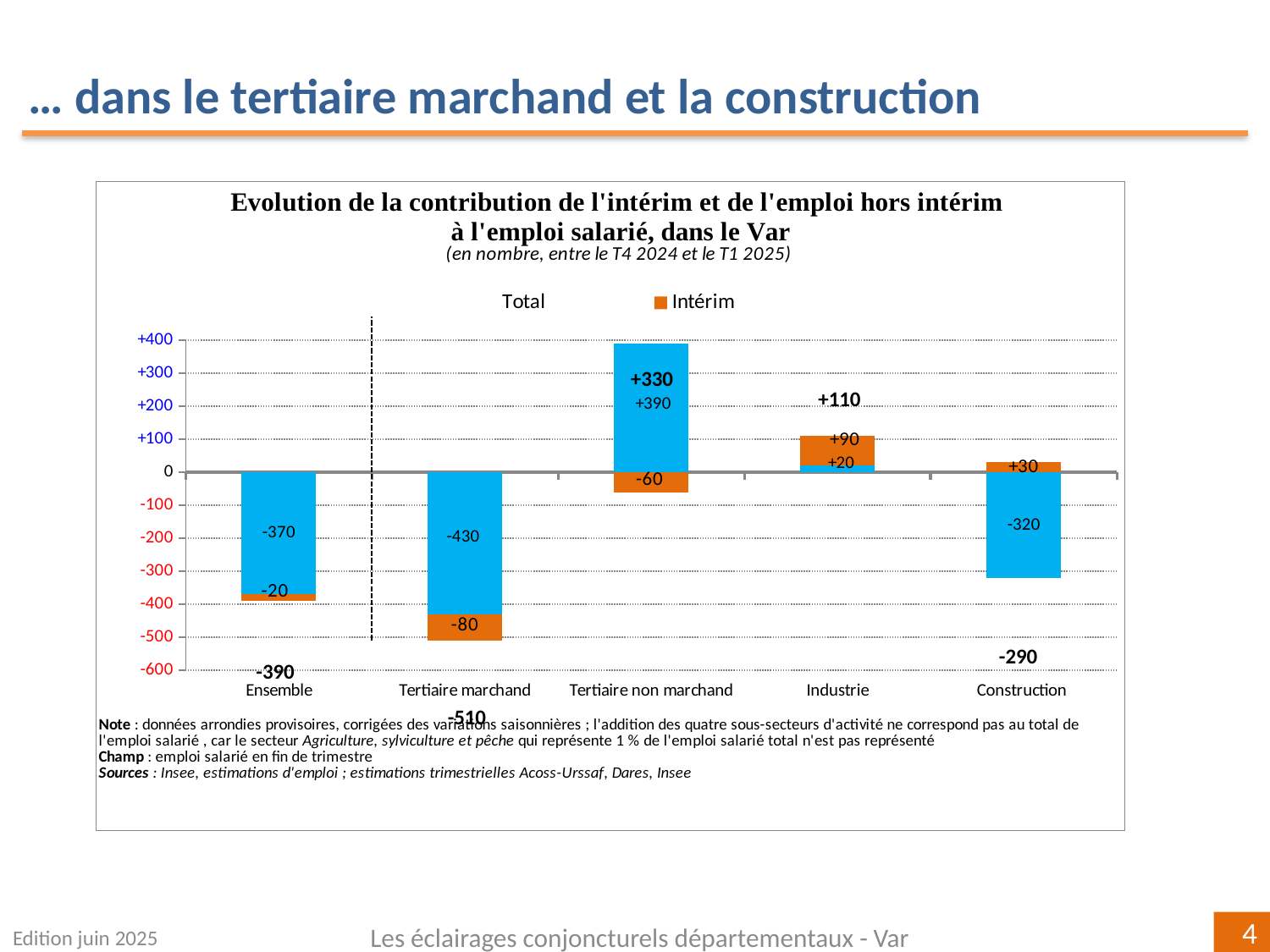
What is the value of the blue segment for Tertiaire marchand? -430 What is the difference between the Intérim values for Industrie and Construction? 60 Which category has the highest total value? Tertiaire non marchand What is the Intérim value for Tertiaire marchand? -80 What is the Intérim value for Industrie? +90 What kind of chart is shown on the slide? bar chart What is the total value shown for Construction? -290 How many sector categories are shown on the x axis of the chart? 5 What is the total value shown for Tertiaire non marchand? +330 Which category has the lowest total value? Tertiaire marchand Which has the larger Intérim value, Industrie or Construction? Industrie What is the Intérim value for Ensemble? -20